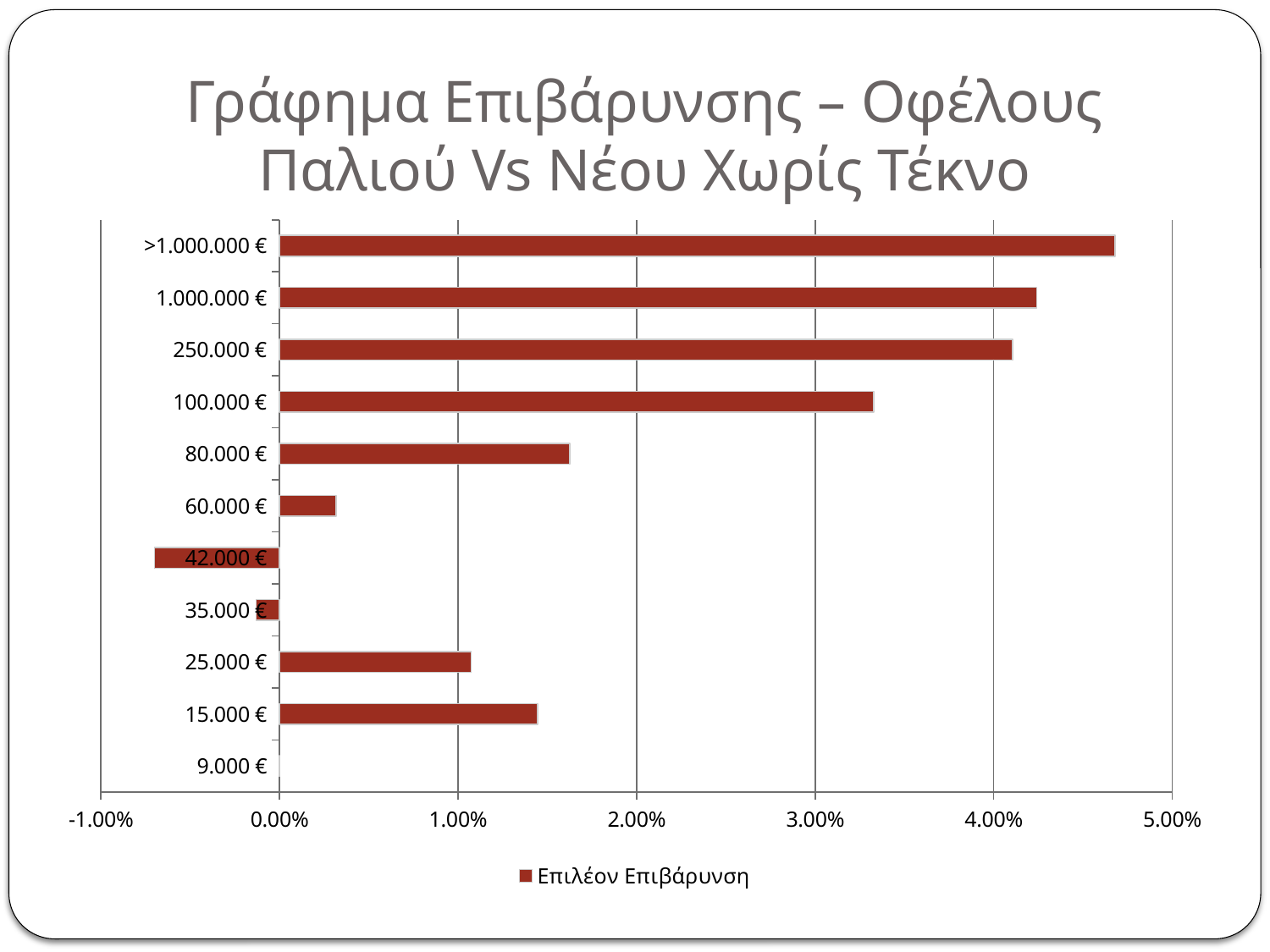
How many series does the legend list? 1 Is the value for 80.000 € greater or less than 2.00%? less Is the value for 100.000 € greater or less than 3.00%? greater Which has the larger value, 60.000 € or 80.000 €? 80.000 € What kind of chart is shown on the slide? bar chart Is the value for >1.000.000 € greater or less than 4.00%? greater Which category has the lowest value? 42.000 € How many categories are listed on the vertical axis of the chart? 11 What is the name of the series shown in the legend? Επιλέον Επιβάρυνση Which has the larger value, 15.000 € or 25.000 €? 15.000 € Which category has the highest value? >1.000.000 €